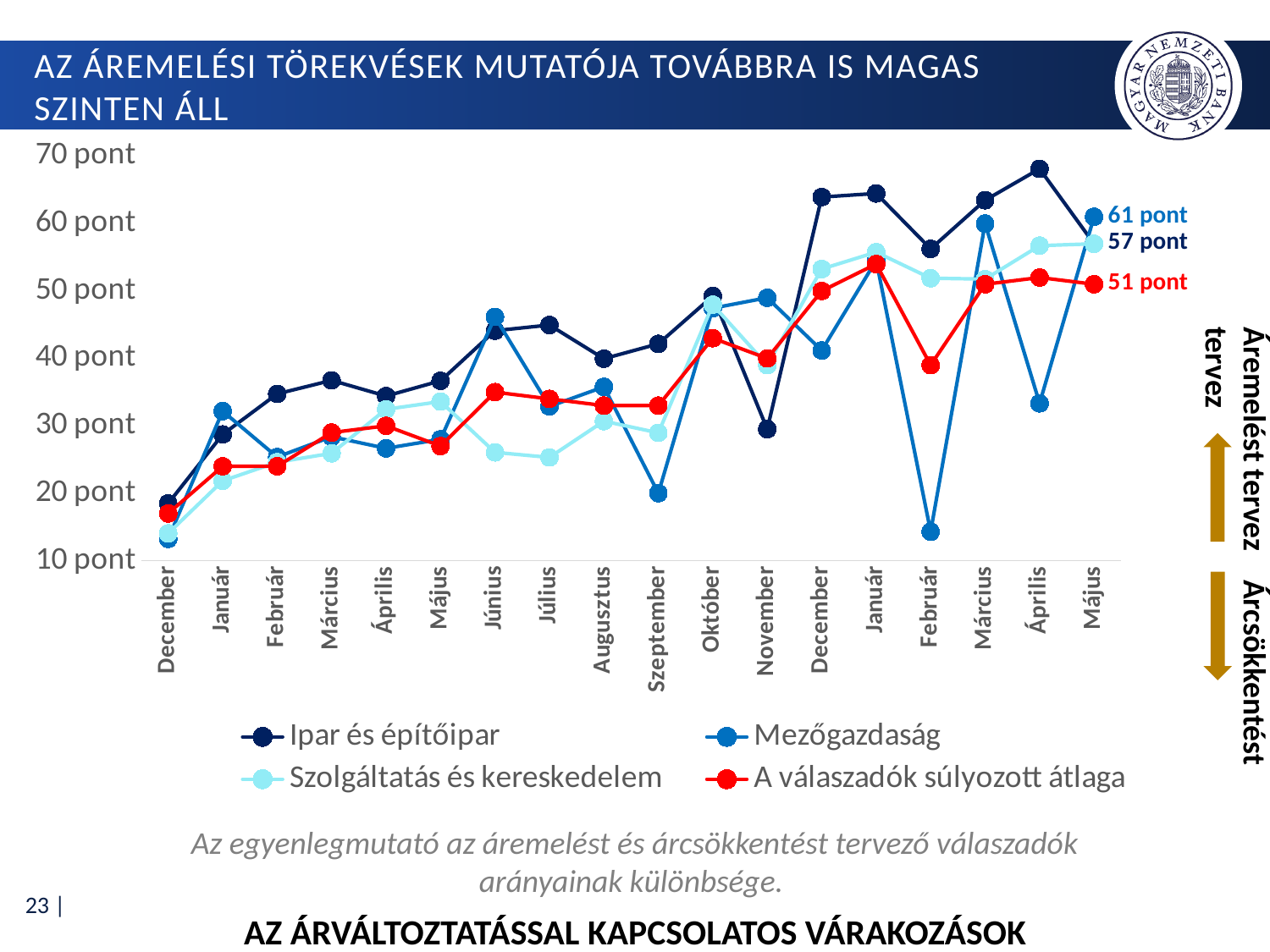
What kind of chart is shown on the slide? line chart In the second Február, which series has the larger value: Ipar és építőipar or Mezőgazdaság? Ipar és építőipar What is the lowest value shown on the y axis? 10 pont Is the value for Mezőgazdaság in the second Február greater or less than 20 pont? less Which series is drawn in red? A válaszadók súlyozott átlaga In which month does the Mezőgazdaság series reach its lowest value? the first December How many series does the legend list? 4 What is the highest value labelled at the right end of the chart? 61 pont What value is labelled at the end of the red line (A válaszadók súlyozott átlaga) in the final Május? 51 pont How many months are shown along the x axis? 18 Is the value for Ipar és építőipar in the second Április greater or less than 60 pont? greater Does the A válaszadók súlyozott átlaga series generally rise or fall from the first December to the last Május? rise